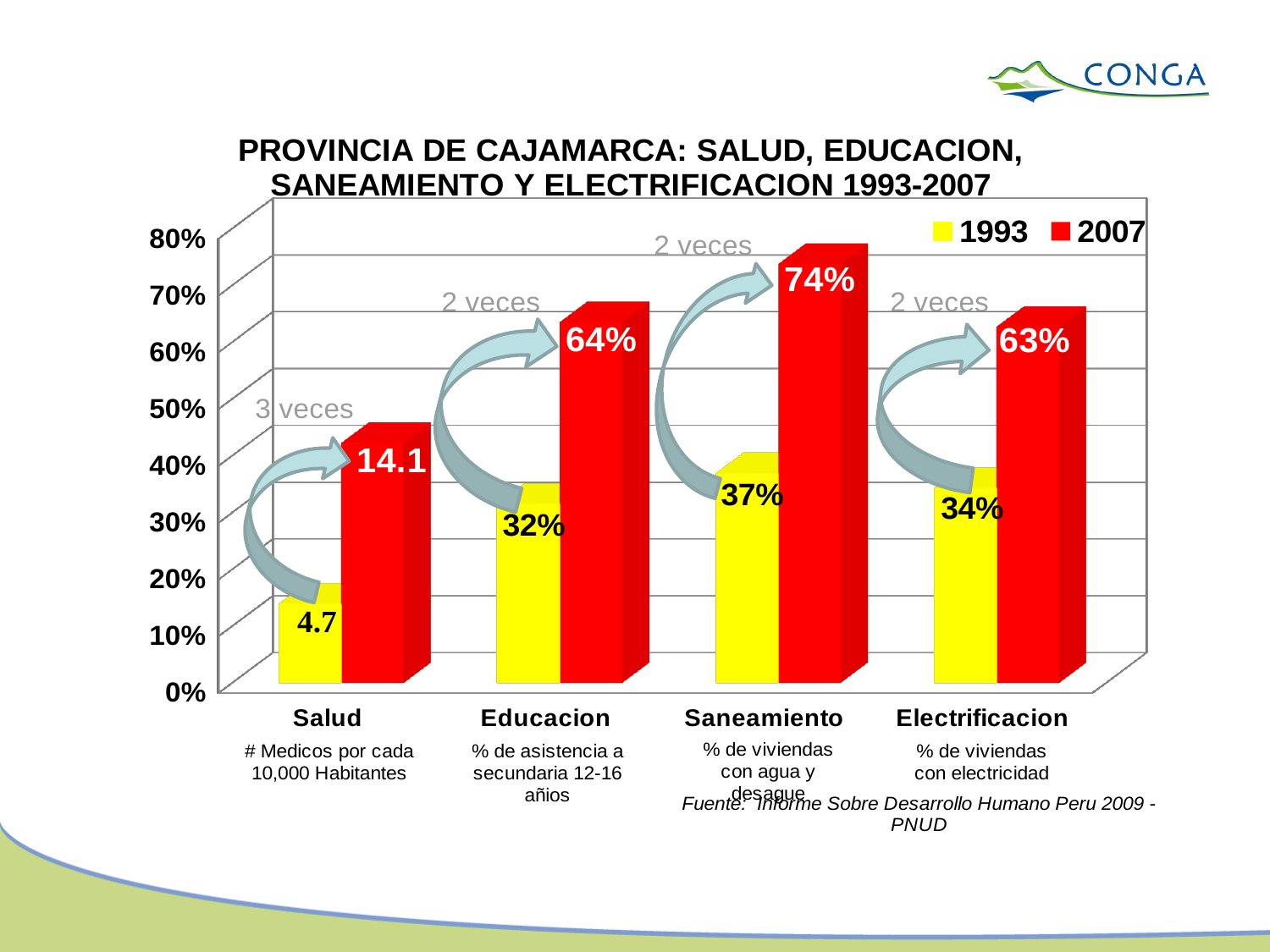
Which category has the lowest 1993 value? Salud What is the 1993 value for Salud? 4.7 What kind of chart is shown on the slide? Bar chart How many categories are shown on the x axis? 4 What is the difference between the 2007 and 1993 values for Educacion? 32% What is the 2007 value for Electrificacion? 63% How many series does the legend list? 2 What is the 2007 value for Saneamiento? 74% Which is larger, the 2007 value for Educacion or the 2007 value for Electrificacion? Educacion Which category has the highest 2007 value? Saneamiento What is the difference between the 2007 and 1993 values for Saneamiento? 37% What is the 1993 value for Educacion? 32%